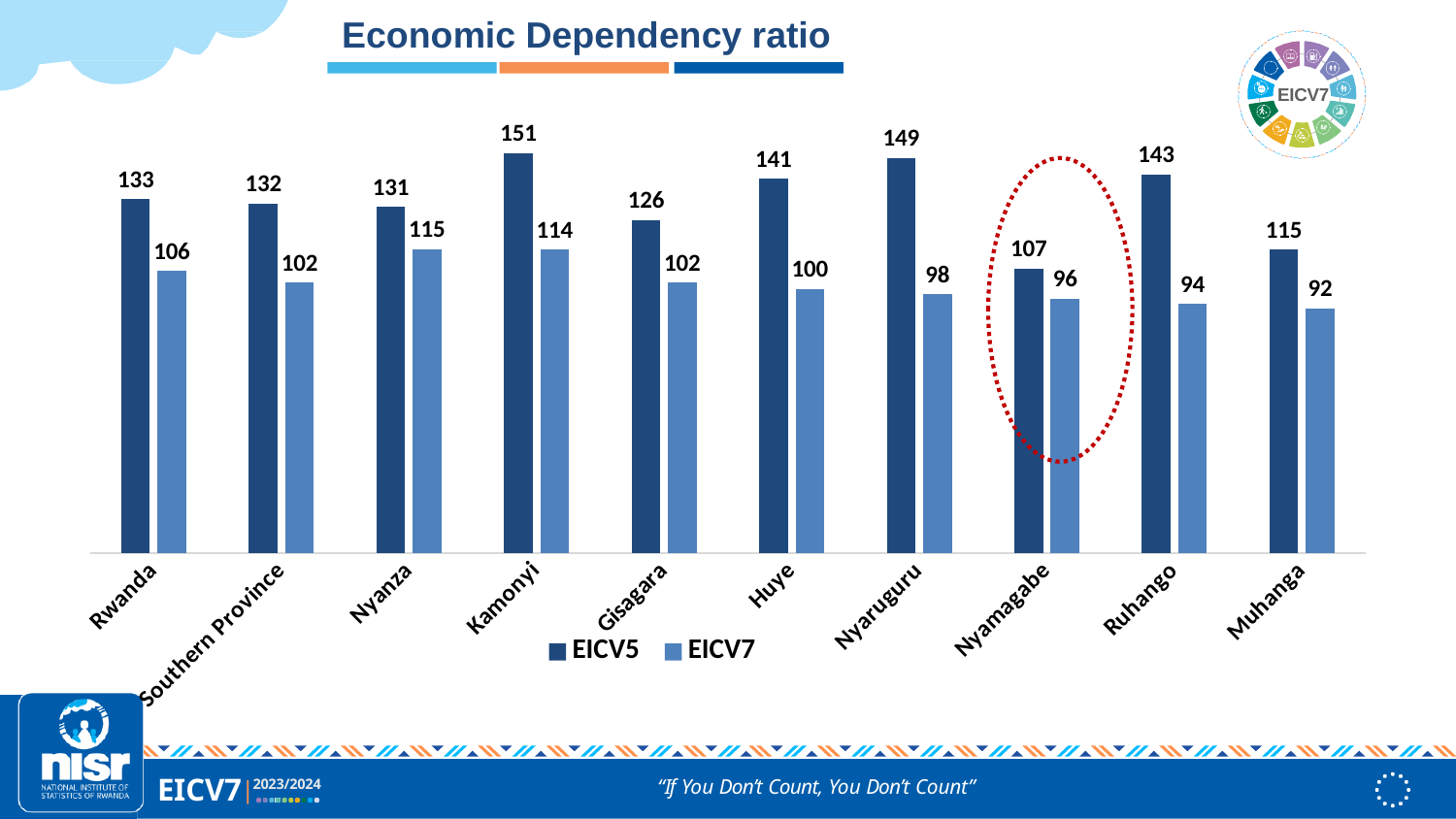
What is the EICV7 value for Nyamagabe? 96 How many categories are shown on the x axis? 10 Which category has the lowest EICV7 value? Muhanga Which category has the lowest EICV5 value? Nyamagabe What is the EICV5 value for Kamonyi? 151 What kind of chart is shown on the slide? Bar chart What is the title of the chart? Economic Dependency ratio What is the difference between the EICV5 and EICV7 values for Nyaruguru? 51 Which is larger, the EICV7 value for Nyanza or the EICV7 value for Huye? Nyanza How many series does the legend list? 2 What is the EICV7 value for Rwanda? 106 Which category has the highest EICV5 value? Kamonyi